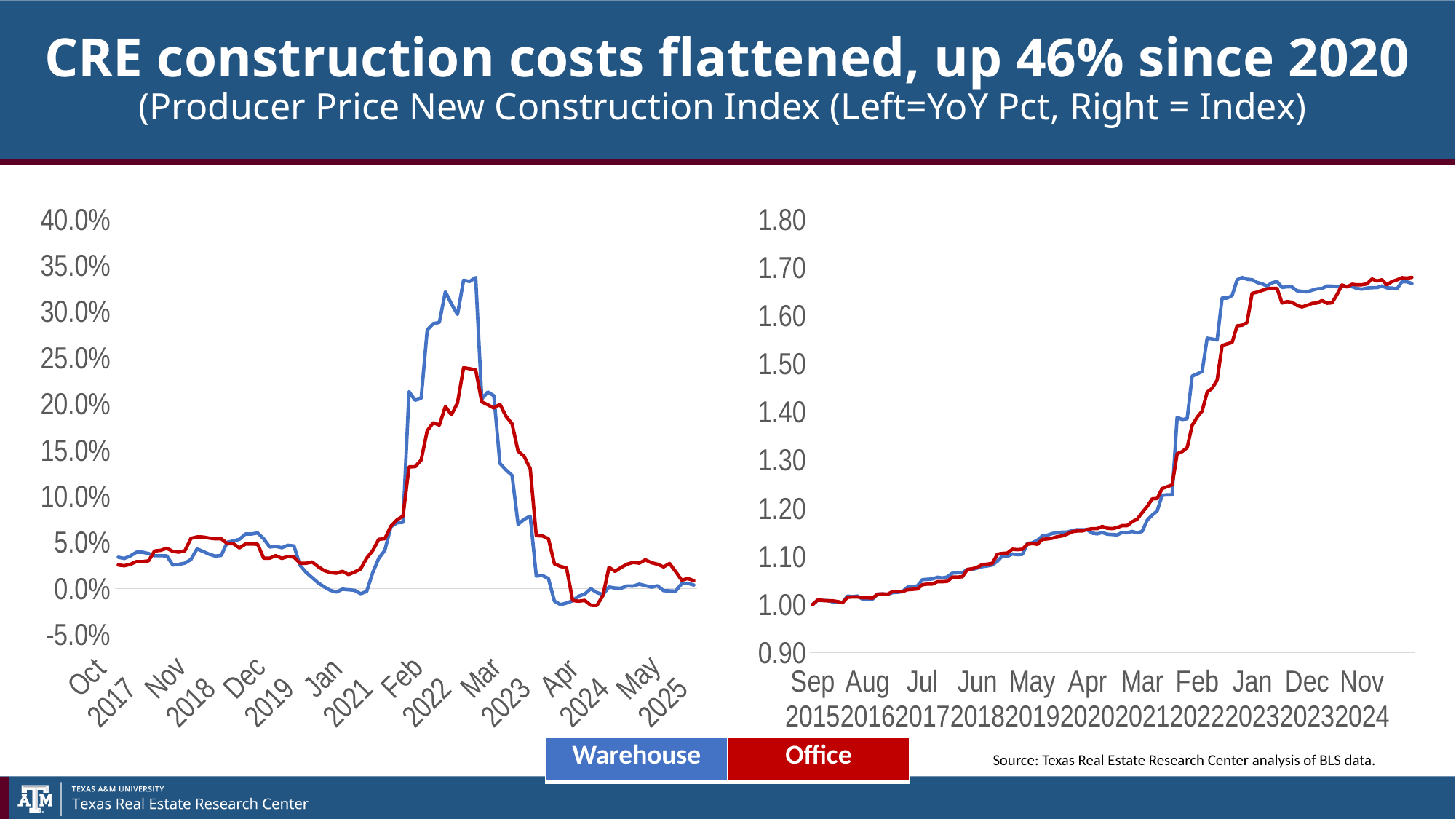
On the right chart (Index), what is the index value at the start of the series in Sep 2015? 1.00 Which series is shown in red in the legend? Office On the left chart (YoY Pct), is the peak value for Warehouse greater or less than 30.0%? greater How many series does the legend list? 2 On the left chart (YoY Pct), is the peak value for Office greater or less than 20.0%? greater Which series is shown in blue in the legend? Warehouse On the left chart (YoY Pct), do the values rise or fall from the 2022 peak to 2024? fall What kind of chart is the left chart (YoY Pct)? line chart On the right chart (Index), do the values rise or fall overall from Sep 2015 to the end of the series? rise On the right chart (Index), is the final value for Warehouse greater or less than 1.60? greater What kind of chart is the right chart (Index)? line chart On the left chart (YoY Pct), which series reaches the higher peak around 2022, Warehouse or Office? Warehouse